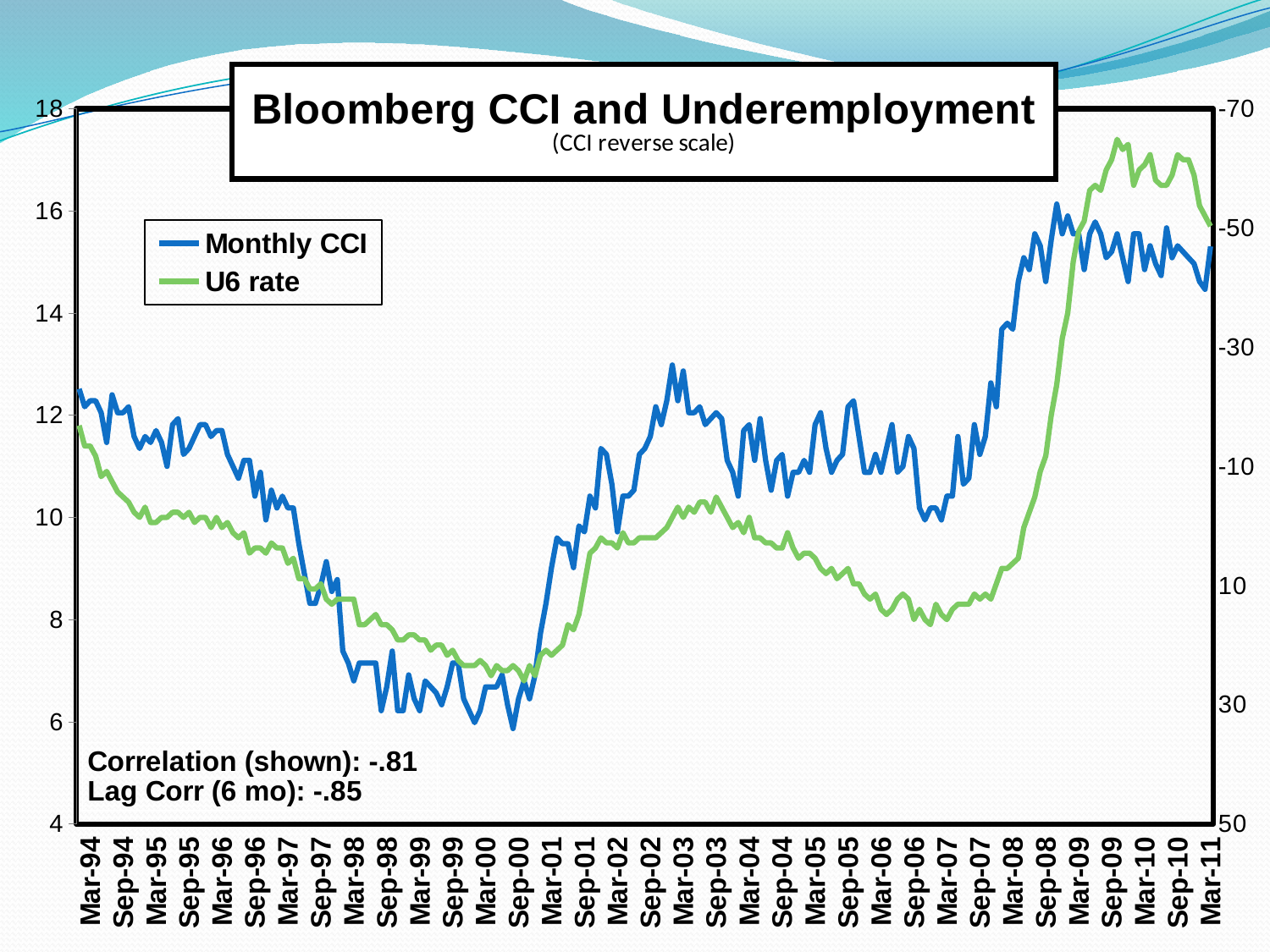
Is the U6 rate at Mar-11 greater or less than 14 on the left axis? greater What are the two series named in the legend? Monthly CCI and U6 rate Is the U6 rate at Sep-09 greater or less than 16 on the left axis? greater Is the U6 rate at Mar-94 greater or less than 10 on the left axis? greater How many series does the legend list? 2 Is the U6 rate higher at Mar-94 or at Mar-11? Mar-11 What kind of chart is shown on the slide? Line chart Does the U6 rate rise or fall between Sep-06 and Sep-09? rise What correlation value is shown on the chart for the two series? -.81 Is the U6 rate higher at Sep-99 or at Sep-09? Sep-09 Does the U6 rate rise or fall between Mar-94 and Sep-99? fall